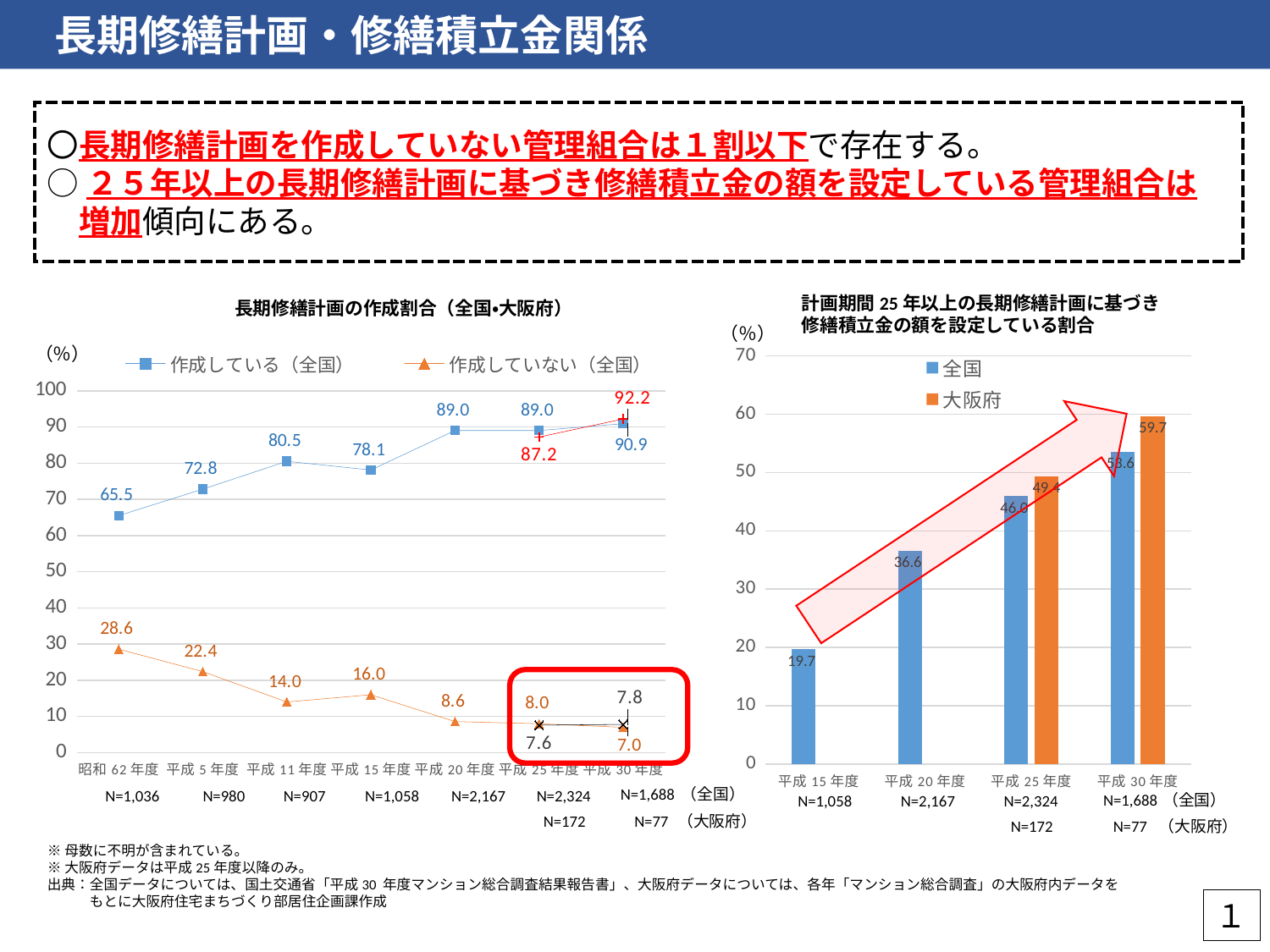
In the left chart (長期修繕計画の作成割合), how many year categories are shown on the x axis? 7 What type of chart is the left chart (長期修繕計画の作成割合)? line chart In the left chart (長期修繕計画の作成割合), how many series does the legend list? 2 In the left chart (長期修繕計画の作成割合), which year has the highest value for 作成していない（全国）? 昭和62年度 In the right chart (計画期間25年以上の長期修繕計画に基づき修繕積立金の額を設定している割合), what is the value for 大阪府 in 平成30年度? 59.7 What type of chart is the right chart (計画期間25年以上の長期修繕計画に基づき修繕積立金の額を設定している割合)? bar chart In the right chart (計画期間25年以上の長期修繕計画に基づき修繕積立金の額を設定している割合), what is the value for 全国 in 平成15年度? 19.7 In the left chart (長期修繕計画の作成割合), what is the difference between the 作成している（全国） values for 平成30年度 and 昭和62年度? 25.4 In the right chart (計画期間25年以上の長期修繕計画に基づき修繕積立金の額を設定している割合), which is larger in 平成25年度, 全国 or 大阪府? 大阪府 In the left chart (長期修繕計画の作成割合), what is the value for 作成している（全国） in 昭和62年度? 65.5 In the left chart (長期修繕計画の作成割合), does the 作成していない（全国） series generally rise or fall from 昭和62年度 to 平成30年度? fall In the left chart (長期修繕計画の作成割合), what is the value for 作成していない（全国） in 平成30年度? 7.0